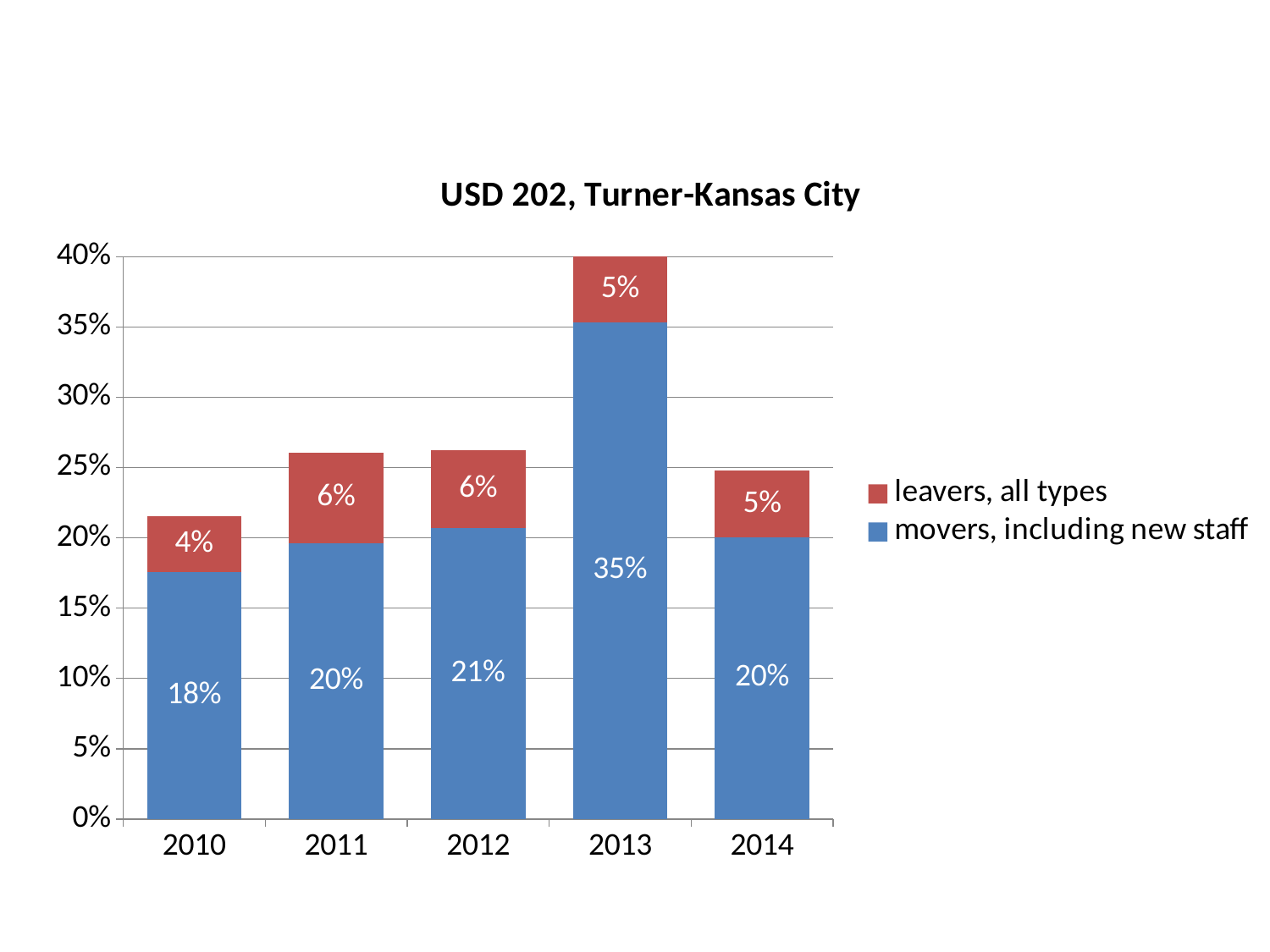
Which year has the lowest value for movers, including new staff? 2010 What is the title of the chart? USD 202, Turner-Kansas City Which year has the highest value for movers, including new staff? 2013 What is the value for leavers, all types in 2010? 4% What is the difference between the movers, including new staff values for 2013 and 2010? 17% Which year has the lowest value for leavers, all types? 2010 How many series does the legend list? 2 What is the value for movers, including new staff in 2013? 35% Is the total height of the 2010 stacked bar greater or less than 25%? less What is the value for movers, including new staff in 2012? 21% Which is larger: the leavers, all types value for 2011 or for 2014? 2011 How many years are shown on the x axis? 5